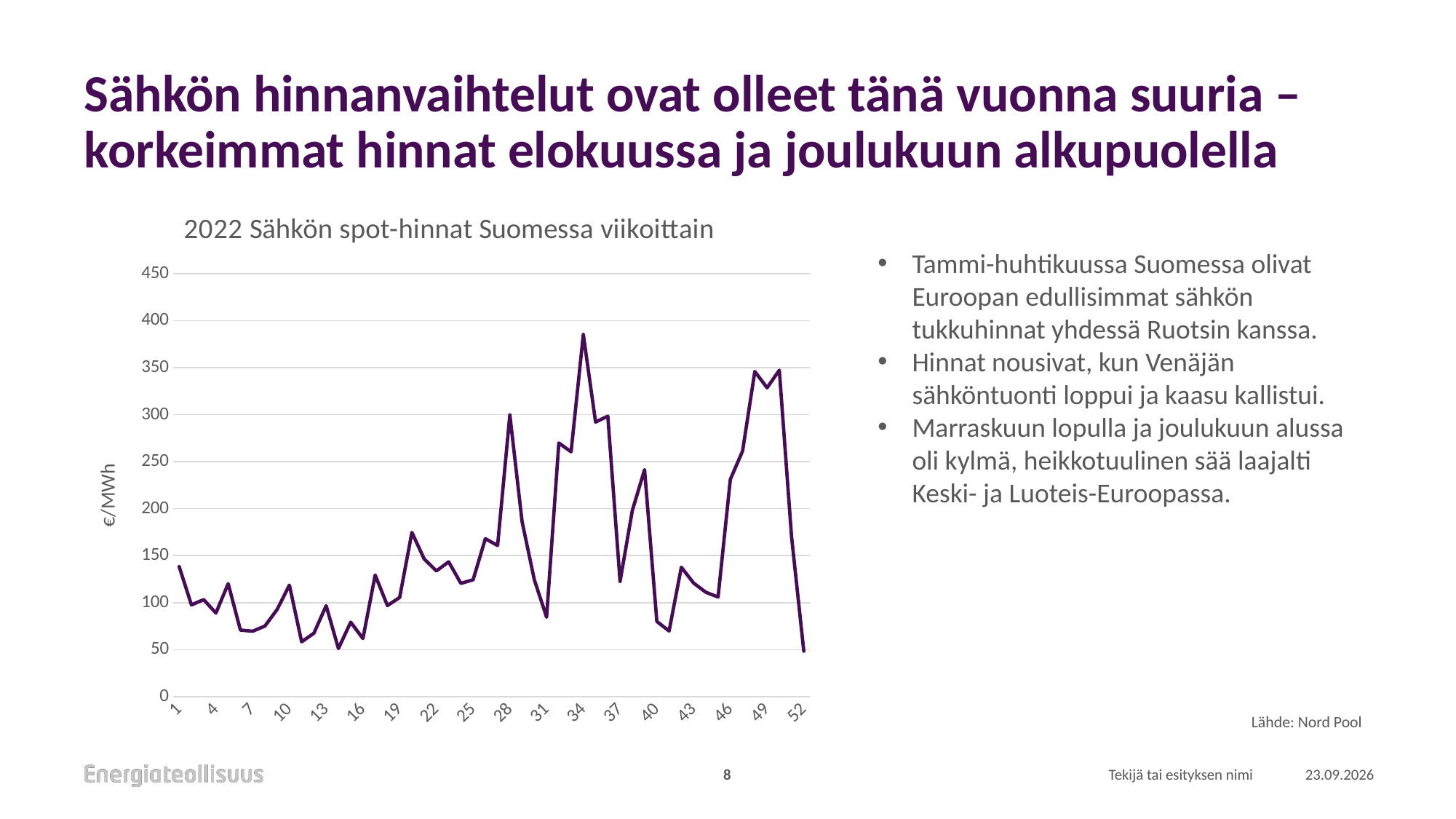
What is the title of the chart? 2022 Sähkön spot-hinnat Suomessa viikoittain Is the value for week 1 greater or less than 150? less Do the values rise or fall from week 49 to week 52? fall Which week has the higher spot price, week 34 or week 48? week 34 Is the value for week 48 greater or less than 300? greater What unit is shown on the vertical axis of the chart? €/MWh Is the value for week 7 greater or less than 100? less In which week does the spot price reach its highest value? 34 What kind of chart is shown on the slide? line chart Which week has the higher spot price, week 1 or week 7? week 1